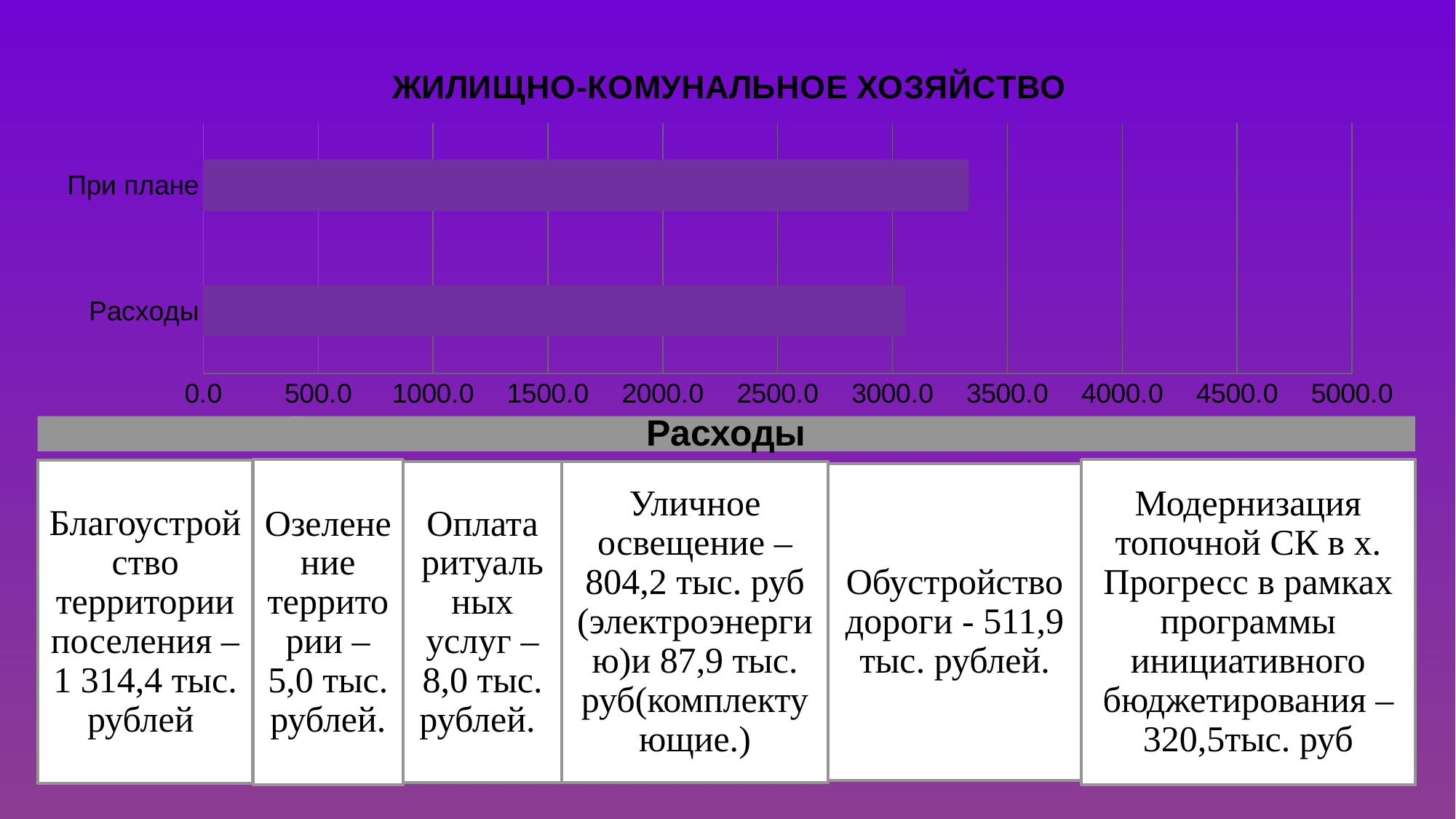
Is the value for При плане greater or less than 3000.0? greater What are the two category labels on the vertical axis of the chart? При плане, Расходы Which category has the shorter bar? Расходы Is the value for Расходы greater or less than 3500.0? less Which category has the longer bar? При плане What is the title of the chart? ЖИЛИЩНО-КОМУНАЛЬНОЕ ХОЗЯЙСТВО How many categories (bars) does the chart show? 2 Is the value for При плане greater or less than 3500.0? less What kind of chart is shown on the slide? bar chart Which is larger, the value for При плане or the value for Расходы? При плане What is the maximum value shown on the horizontal axis? 5000.0